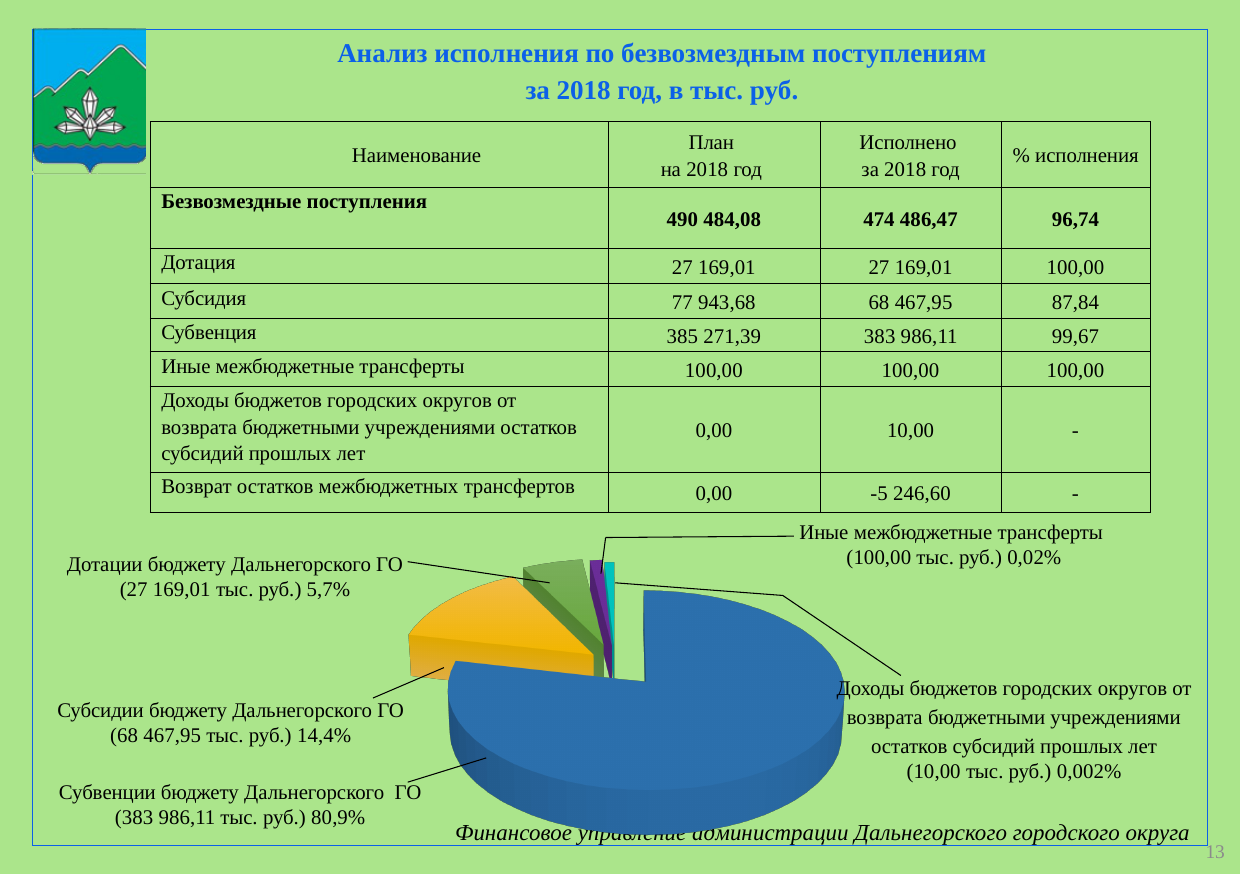
Which slice of the pie chart is the smallest? Доходы бюджетов городских округов от возврата бюджетными учреждениями остатков субсидий прошлых лет What value in тыс. руб. is shown for the slice 'Иные межбюджетные трансферты' in the pie chart? 100,00 тыс. руб. How many slices does the pie chart have? 5 Which slice of the pie chart is the largest? Субвенции бюджету Дальнегорского ГО What share of the pie does the slice 'Дотации бюджету Дальнегорского ГО' represent? 5,7% What is the difference in percentage points between the 'Субсидии' slice (14,4%) and the 'Дотации' slice (5,7%) in the pie chart? 8,7 What value in тыс. руб. is shown for the slice 'Субвенции бюджету Дальнегорского ГО' in the pie chart? 383 986,11 тыс. руб. What share of the pie does the slice 'Субвенции бюджету Дальнегорского ГО' represent? 80,9% What kind of chart is shown at the bottom of the slide? Pie chart What share of the pie does the slice 'Субсидии бюджету Дальнегорского ГО' represent? 14,4% What colour is the largest slice of the pie chart? Blue In the pie chart, which is larger: the slice for 'Субсидии бюджету Дальнегорского ГО' or the slice for 'Дотации бюджету Дальнегорского ГО'? Субсидии бюджету Дальнегорского ГО